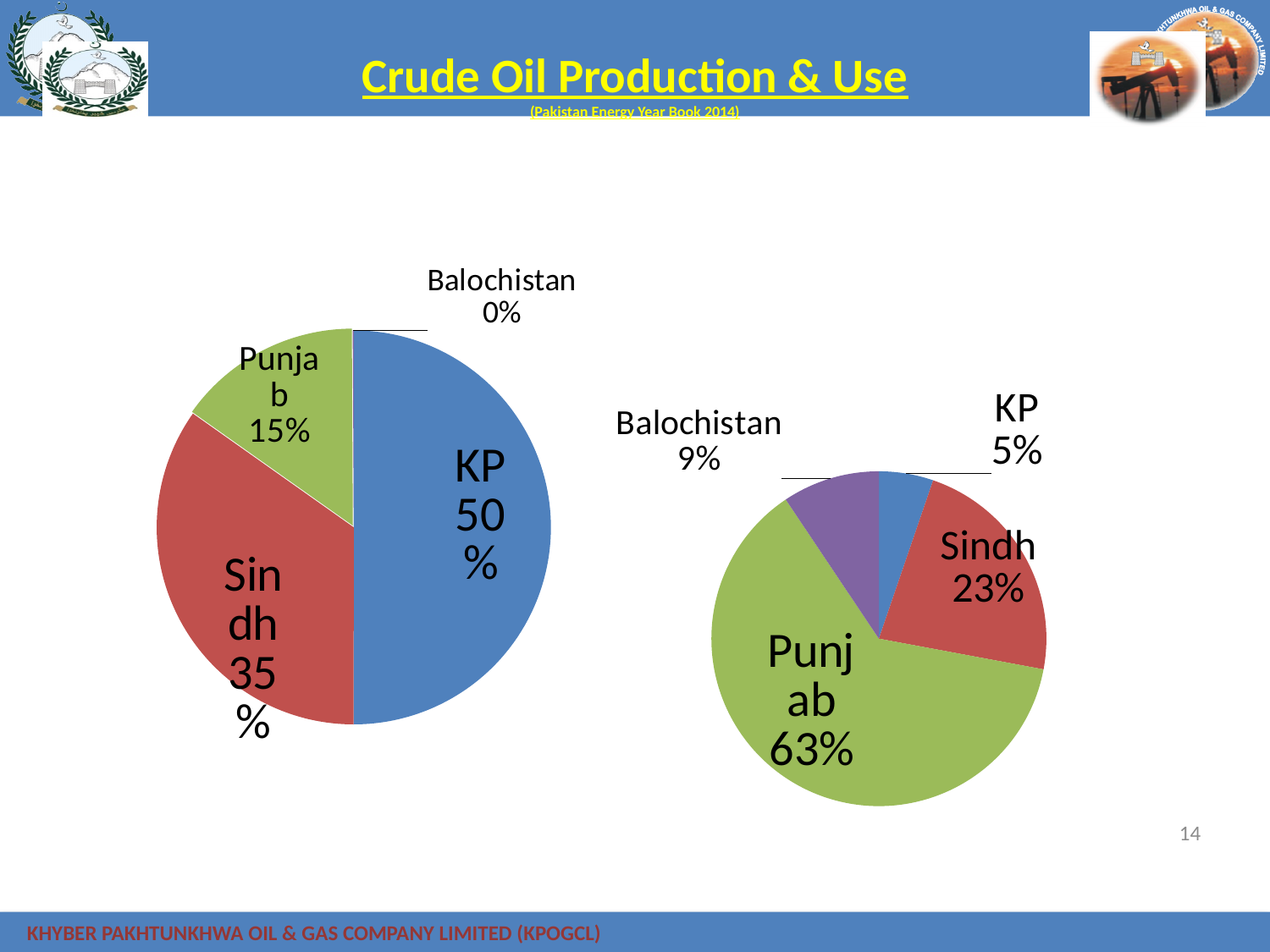
In the right pie chart, what share does Balochistan have? 9% In the left pie chart, what share does Sindh have? 35% In the right pie chart, what share does Sindh have? 23% In the left pie chart, what share does KP have? 50% In the right pie chart, which category has the largest share? Punjab In the left pie chart, what share does Punjab have? 15% In the right pie chart, what share does Punjab have? 63% In the right pie chart, which is larger, the share of Sindh or the share of KP? Sindh In the left pie chart, which category has the smallest share? Balochistan What type of chart is the right chart on the slide? Pie chart In the left pie chart, what is the difference between the shares of KP and Sindh? 15% In the left pie chart, which category has the largest share? KP